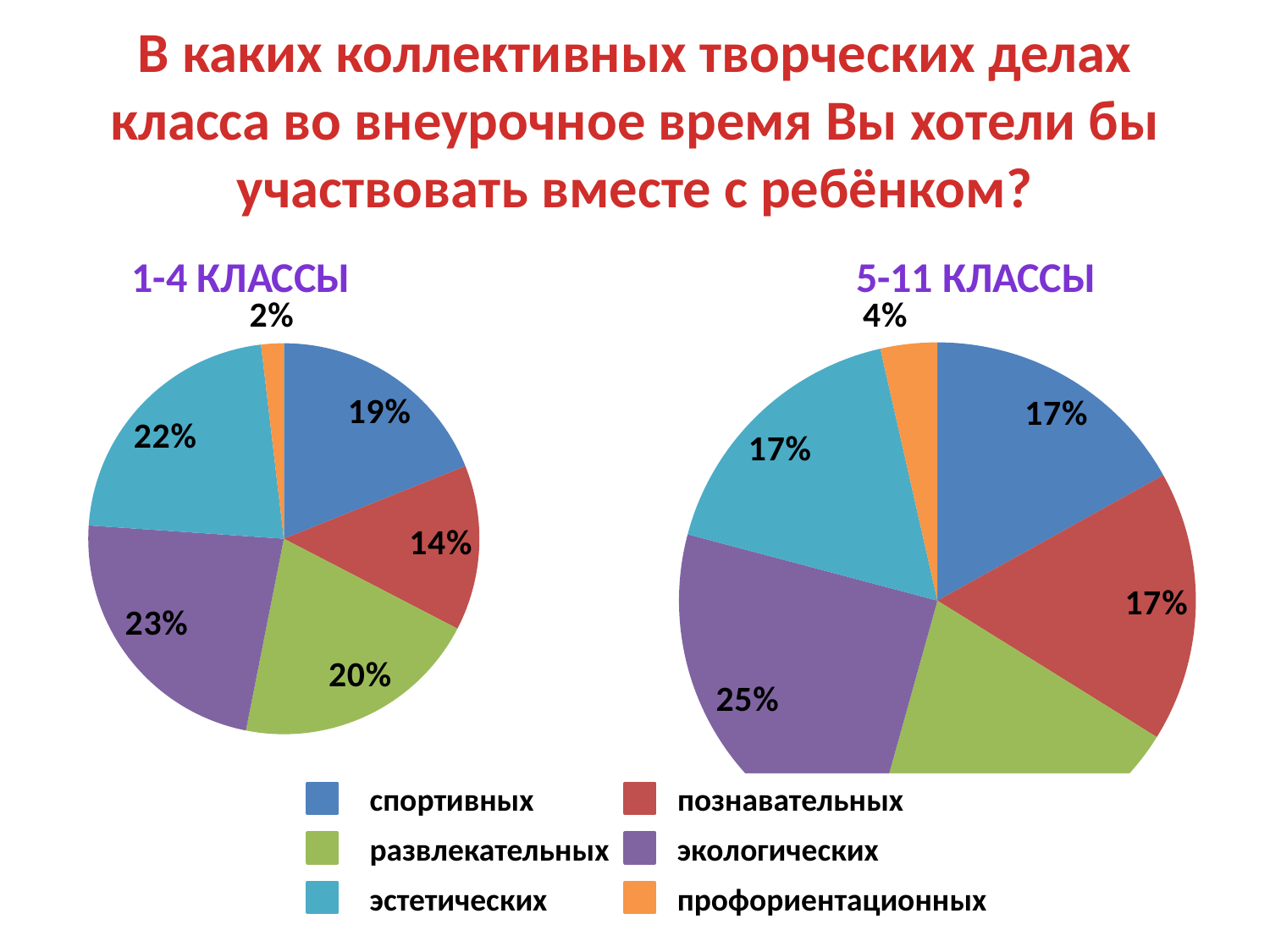
In the 1-4 КЛАССЫ pie chart, what is the difference between the shares for экологических and познавательных? 9% In the 1-4 КЛАССЫ pie chart, which category has the smallest share? профориентационных In the 5-11 КЛАССЫ pie chart, what share is shown for профориентационных? 4% In the legend, which category is shown in orange? профориентационных In the 5-11 КЛАССЫ pie chart, which category has the smallest share? профориентационных In the 1-4 КЛАССЫ pie chart, what share is shown for спортивных? 19% In the 1-4 КЛАССЫ pie chart, what share is shown for познавательных? 14% What type of chart is used for 1-4 КЛАССЫ? pie chart How many categories does the legend list for the pie charts? 6 In the 1-4 КЛАССЫ pie chart, which is larger: the share for развлекательных or the share for познавательных? развлекательных In the 1-4 КЛАССЫ pie chart, which category has the largest share? экологических In the 5-11 КЛАССЫ pie chart, what share is shown for экологических? 25%